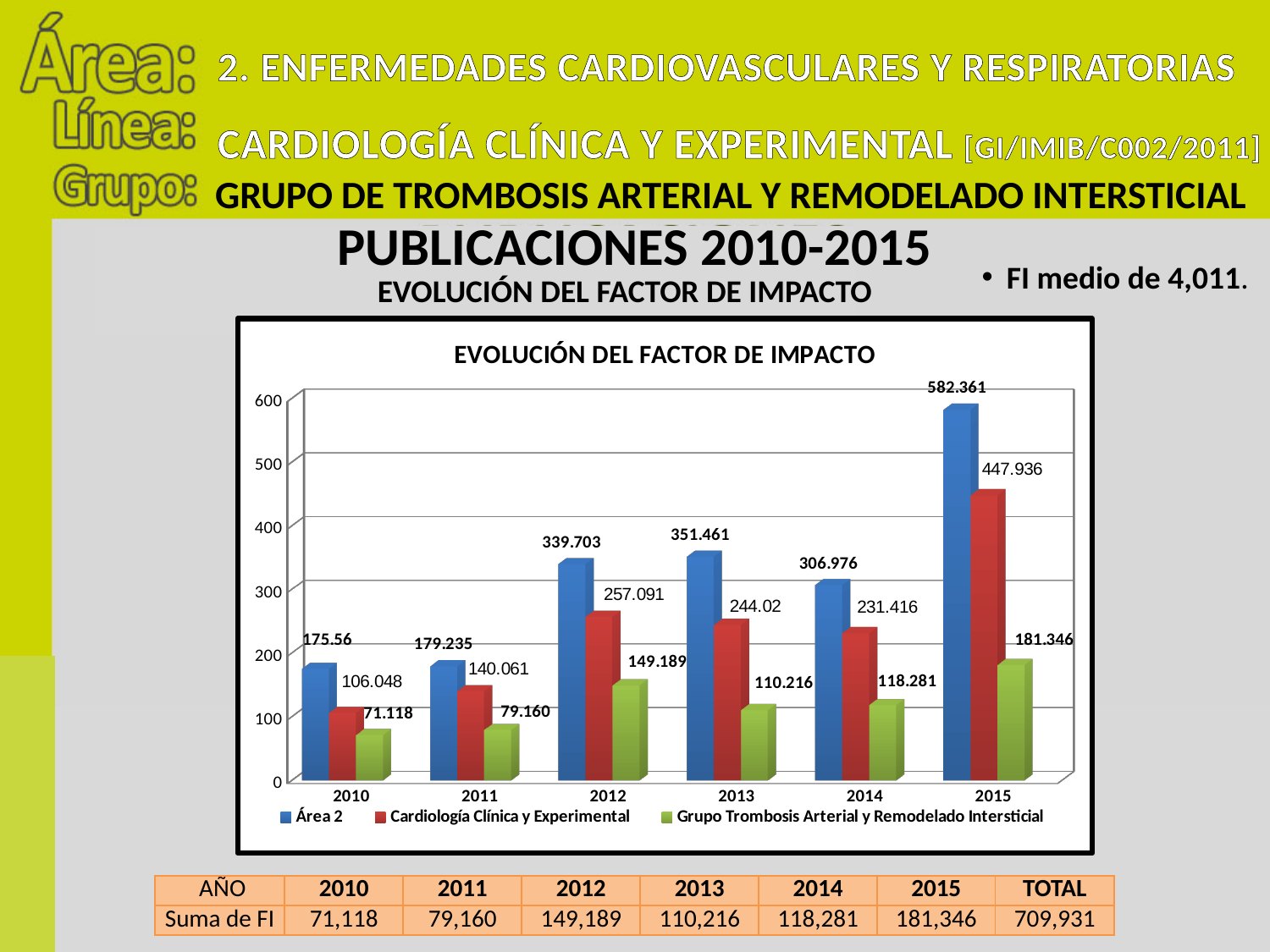
What is the value for Área 2 in 2015? 582.361 How many series does the chart legend list? 3 What is the difference between the Área 2 value in 2015 and the Cardiología Clínica y Experimental value in 2015? 134.425 In which year is the value for Grupo Trombosis Arterial y Remodelado Intersticial lowest? 2010 How many years are shown on the x axis of the chart? 6 What type of chart is shown on the slide? bar chart Which is larger in 2014: the value for Área 2 or the value for Cardiología Clínica y Experimental? Área 2 Is the value for Cardiología Clínica y Experimental in 2011 greater or less than 200? less In which year is the value for Área 2 highest? 2015 What is the title of the chart? EVOLUCIÓN DEL FACTOR DE IMPACTO What is the value for Cardiología Clínica y Experimental in 2012? 257.091 What is the value for Grupo Trombosis Arterial y Remodelado Intersticial in 2013? 110.216